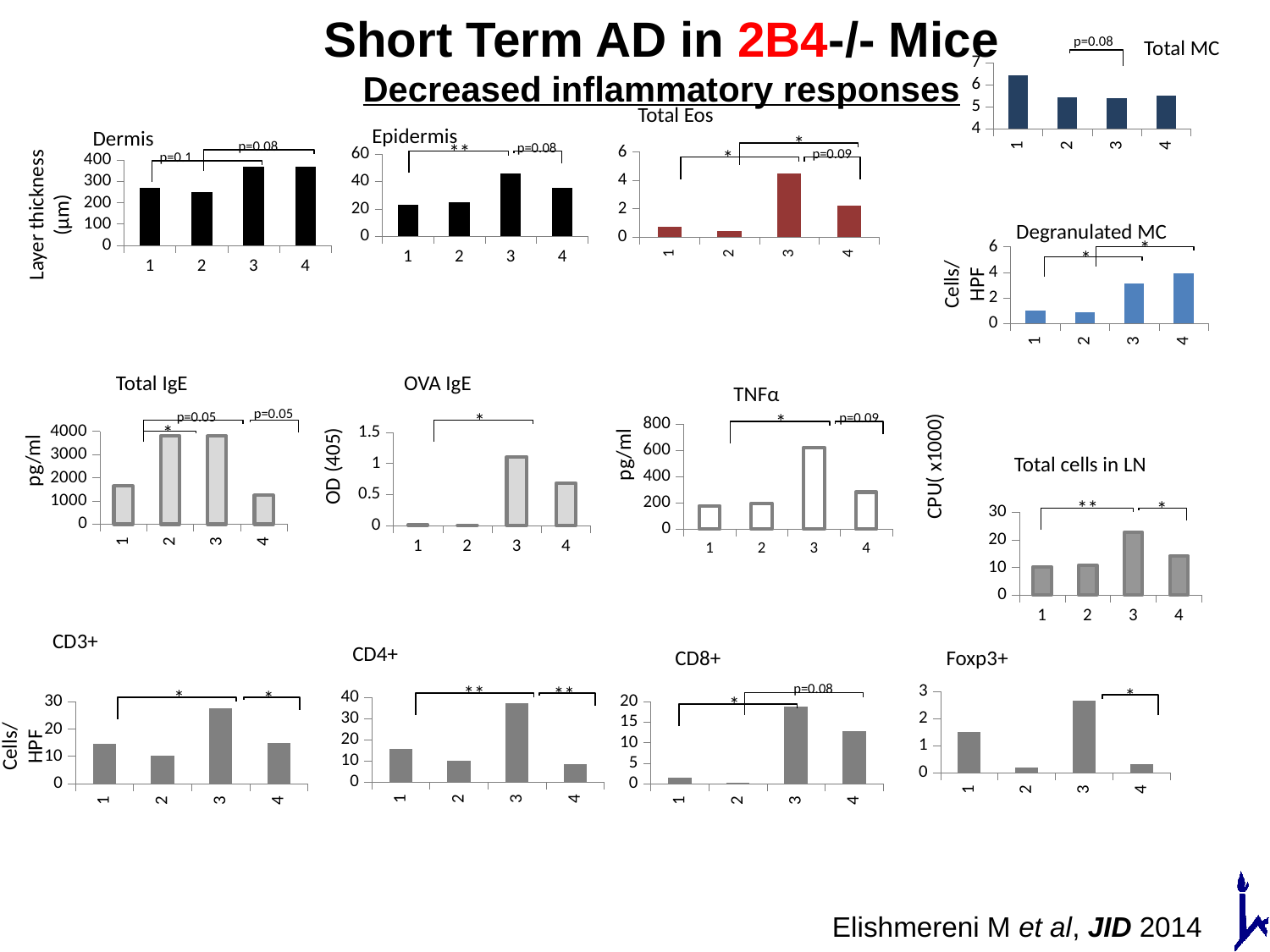
In the Total IgE chart, is the value for category 2 greater or less than 3000? greater In the CD4+ chart, which category has the lowest bar? 4 In the Total cells in LN chart, is the value for category 3 greater or less than 20? greater What kind of chart is the Dermis chart? bar chart In the TNFα chart, which category has the highest bar? 3 In the Total Eos chart, is the value for category 3 greater or less than 4? greater In the Degranulated MC chart, which is larger, the value for category 3 or category 4? 4 In the Total MC chart, which category has the highest bar? 1 In the CD8+ chart, which category has the lowest bar? 2 In the Epidermis chart, which category has the highest bar? 3 How many categories are shown on the x axis of the Foxp3+ chart? 4